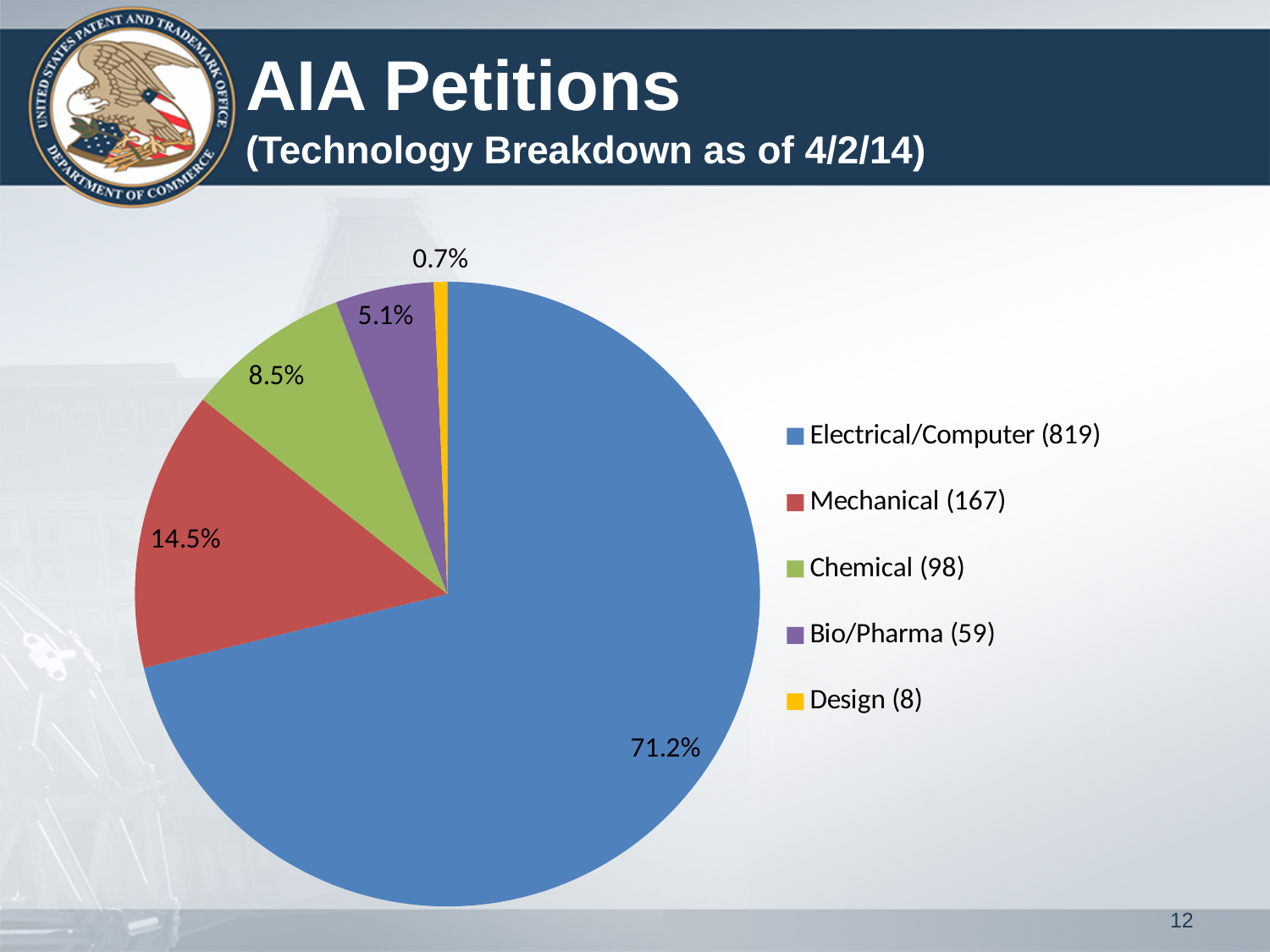
Which has a larger share, Chemical or Bio/Pharma? Chemical What share of the pie does Electrical/Computer represent? 71.2% What is the difference in petition counts between Electrical/Computer and Mechanical? 652 What share of the pie does Design represent? 0.7% Which category has the smallest slice of the pie? Design How many categories does the pie chart show? 5 What share of the pie does Bio/Pharma represent? 5.1% How many petitions does the legend show for Bio/Pharma? 59 How many petitions does the legend show for Mechanical? 167 Which category has the largest slice of the pie? Electrical/Computer